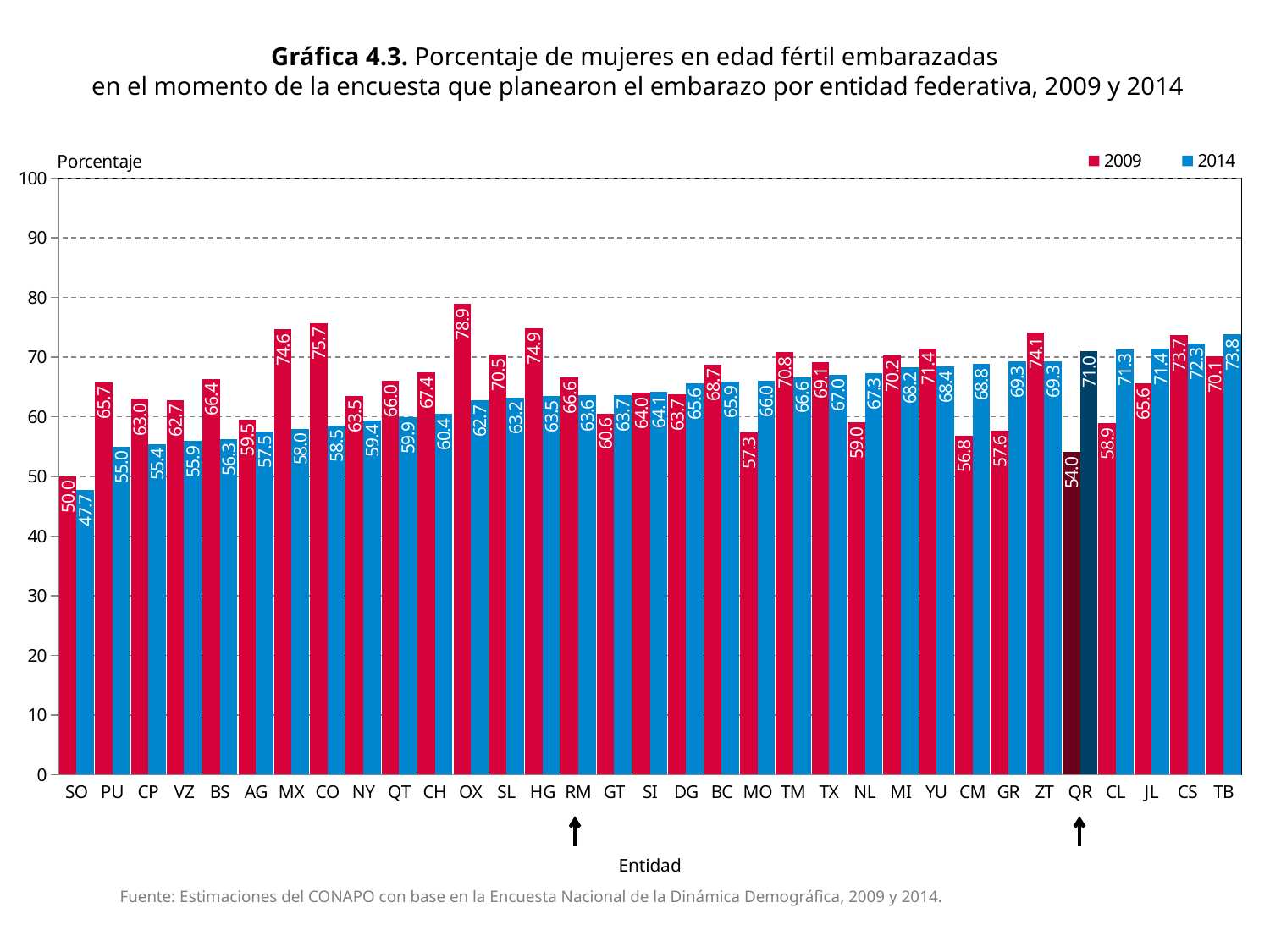
What is the 2009 value for RM? 66.6 Which is larger for NL, the 2009 value or the 2014 value? 2014 Which entity has the highest 2009 value? OX What is the difference between the 2009 and 2014 values for MX? 16.6 What is the 2009 value for OX? 78.9 How many entities are shown on the x axis? 33 What kind of chart is this? bar chart Which entity has the highest 2014 value? TB What is the label of the y axis? Porcentaje Which entity has the lowest 2014 value? SO How many series does the legend list? 2 What is the 2014 value for QR? 71.0